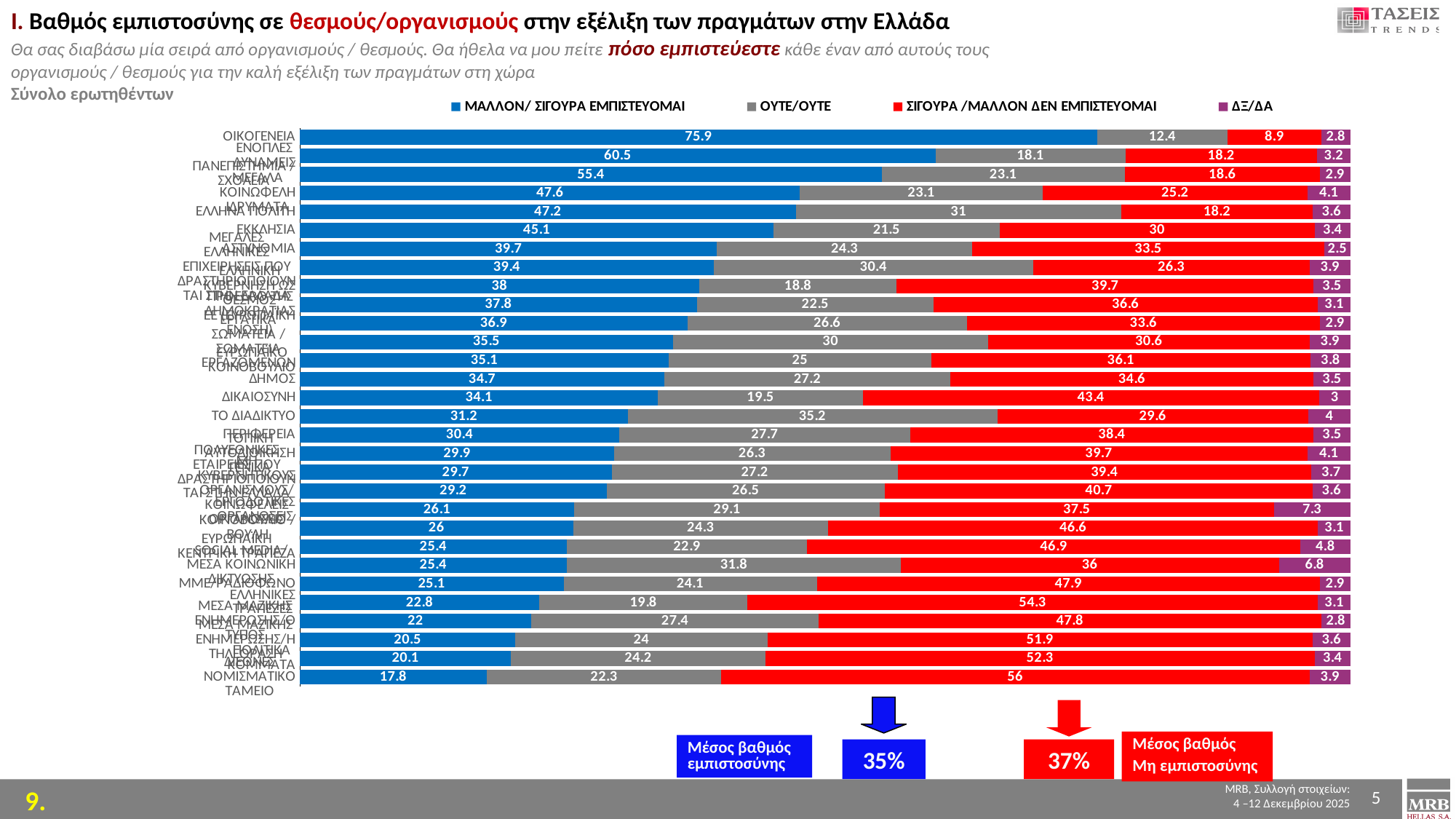
What kind of chart is shown on the slide? bar chart What is the highest value shown in the ΣΙΓΟΥΡΑ/ΜΑΛΛΟΝ ΔΕΝ ΕΜΠΙΣΤΕΥΟΜΑΙ series? 56 How many series does the legend list? 4 What is the ΣΙΓΟΥΡΑ/ΜΑΛΛΟΝ ΔΕΝ ΕΜΠΙΣΤΕΥΟΜΑΙ value for ΔΙΚΑΙΟΣΥΝΗ? 43.4 According to the boxes below the chart, what is the average degree of trust (Μέσος βαθμός εμπιστοσύνης)? 35% What is the ΜΑΛΛΟΝ/ΣΙΓΟΥΡΑ ΕΜΠΙΣΤΕΥΟΜΑΙ value for ΟΙΚΟΓΕΝΕΙΑ? 75.9 What is the ΔΞ/ΔΑ value for ΔΗΜΟΣ? 3.5 What is the ΟΥΤΕ/ΟΥΤΕ value for ΤΟ ΔΙΑΔΙΚΤΥΟ? 35.2 Which category has the highest ΜΑΛΛΟΝ/ΣΙΓΟΥΡΑ ΕΜΠΙΣΤΕΥΟΜΑΙ value? ΟΙΚΟΓΕΝΕΙΑ What is the difference between the ΜΑΛΛΟΝ/ΣΙΓΟΥΡΑ ΕΜΠΙΣΤΕΥΟΜΑΙ values for ΟΙΚΟΓΕΝΕΙΑ and ΕΚΚΛΗΣΙΑ? 30.8 How many categories (institutions) are plotted in the chart? 30 Which is larger for ΕΚΚΛΗΣΙΑ: the ΜΑΛΛΟΝ/ΣΙΓΟΥΡΑ ΕΜΠΙΣΤΕΥΟΜΑΙ value or the ΣΙΓΟΥΡΑ/ΜΑΛΛΟΝ ΔΕΝ ΕΜΠΙΣΤΕΥΟΜΑΙ value? ΜΑΛΛΟΝ/ΣΙΓΟΥΡΑ ΕΜΠΙΣΤΕΥΟΜΑΙ